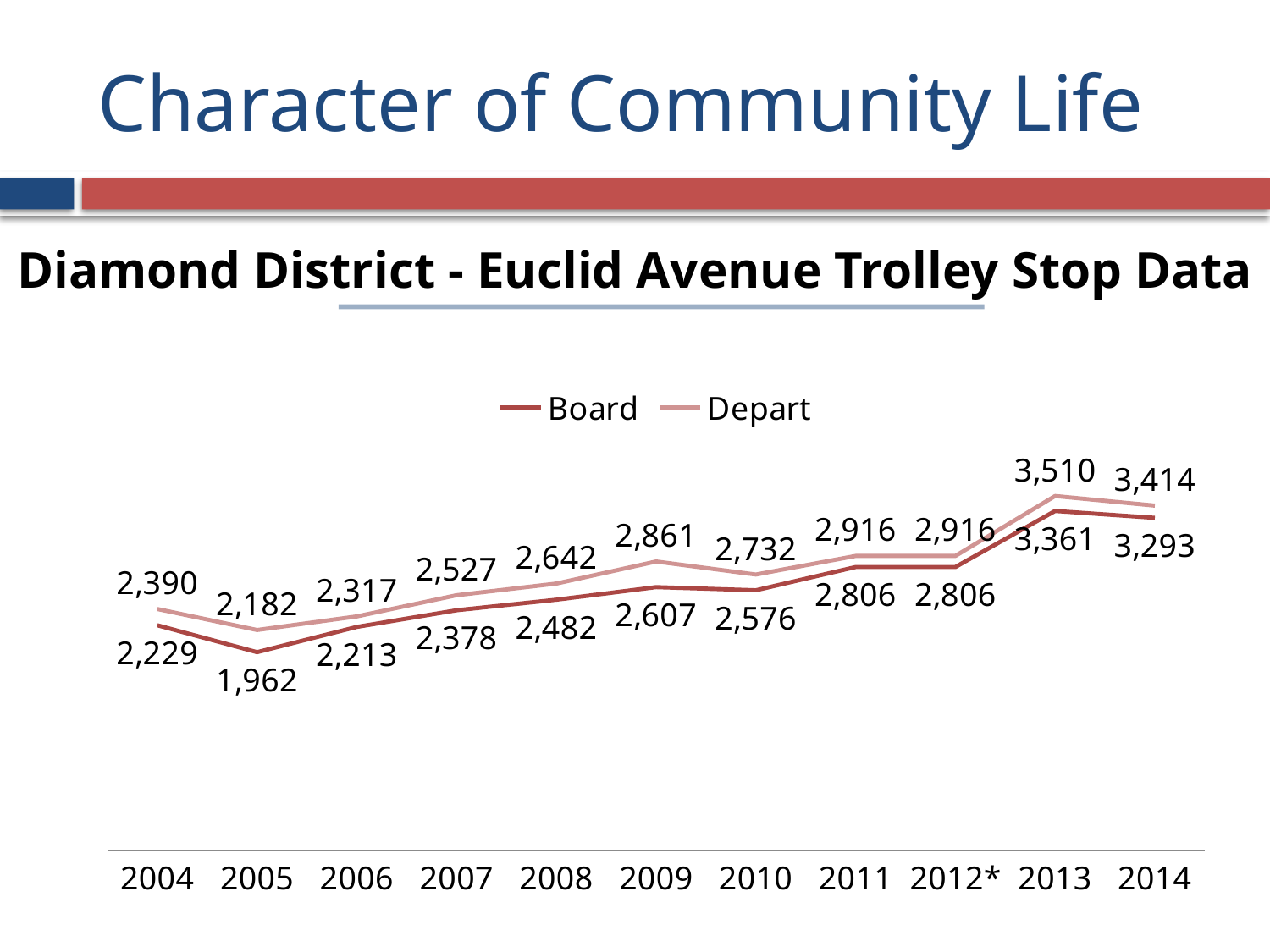
Which is larger in 2010, the Board value or the Depart value? Depart How many series does the legend list? 2 In which year is the Depart value highest? 2013 What is the Depart value for 2009? 2,861 What is the difference between the Depart and Board values in 2014? 121 How many years are shown on the x axis? 11 What type of chart is shown on the slide? Line chart Overall, do the Board values rise or fall from 2004 to 2014? Rise What is the Board value for 2005? 1,962 What is the Board value for 2013? 3,361 What is the title shown above the chart? Diamond District - Euclid Avenue Trolley Stop Data In which year is the Board value lowest? 2005